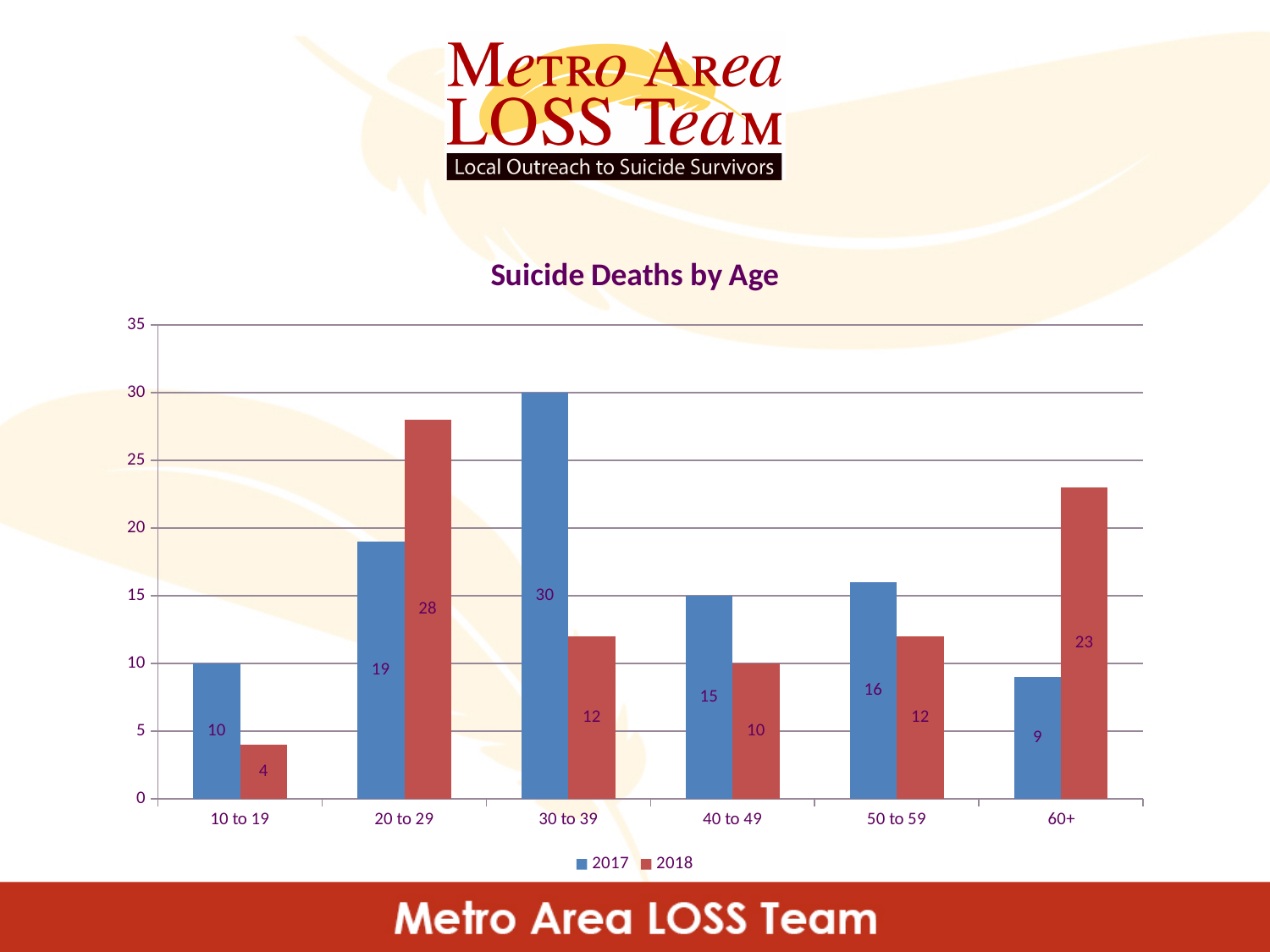
How many age groups are shown on the x axis? 6 Is the value for 2018 in the 20 to 29 age group greater or less than 25? greater Which is larger for the 50 to 59 age group, the 2017 value or the 2018 value? 2017 What is the value for 2017 in the 30 to 39 age group? 30 What is the difference between the 2017 and 2018 values for the 30 to 39 age group? 18 How many series does the legend list? 2 What is the value for 2018 in the 60+ age group? 23 What is the value for 2018 in the 10 to 19 age group? 4 Which age group has the highest value for 2018? 20 to 29 Which age group has the lowest value for 2017? 60+ What kind of chart is shown on the slide? Bar chart What is the title of the chart? Suicide Deaths by Age